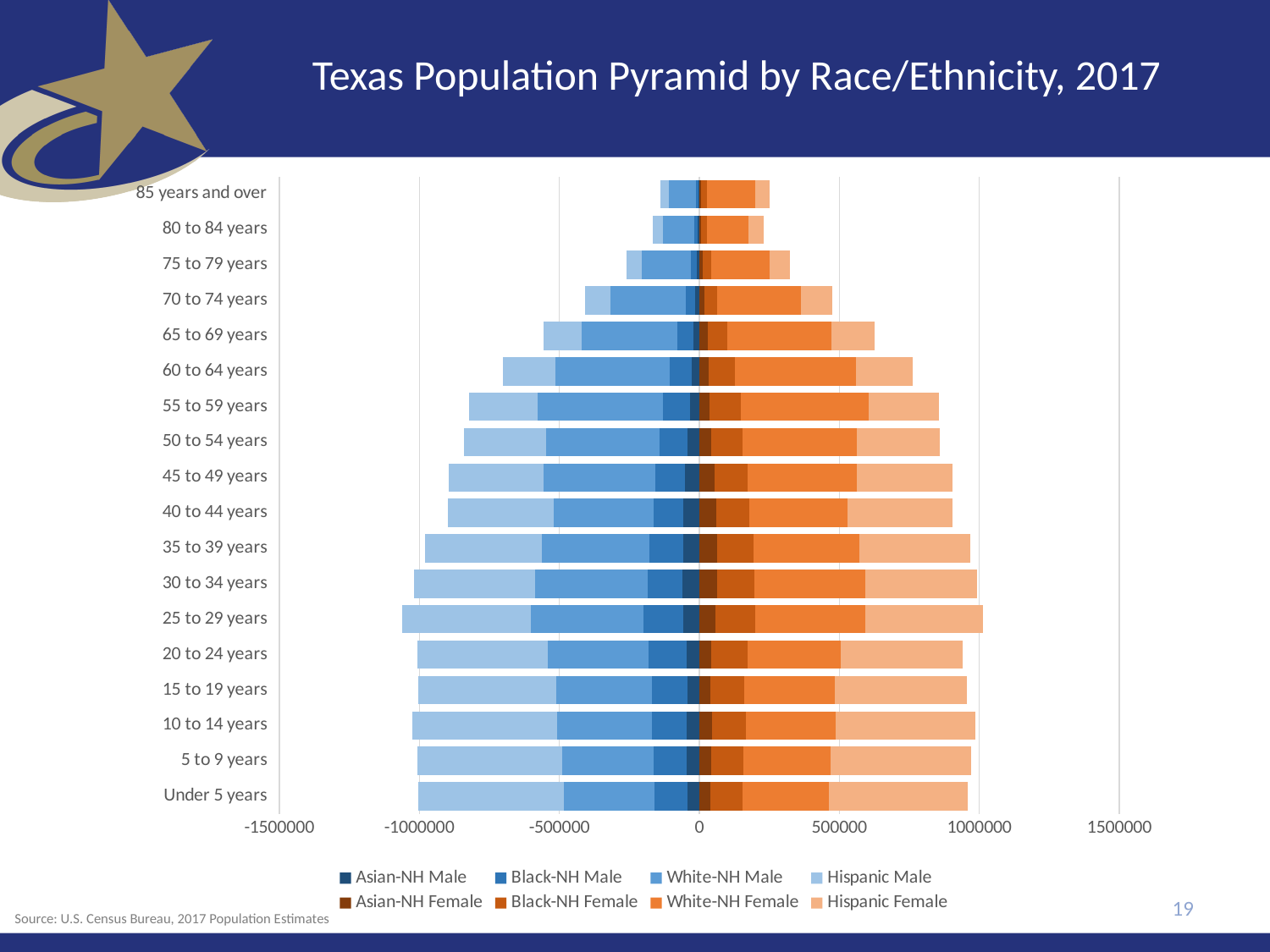
How many series does the legend list? 8 Which is longer, the total female bar for 25 to 29 years or for 75 to 79 years? 25 to 29 years What kind of chart is shown on the slide? Stacked bar chart (population pyramid) Is the total female bar for 85 years and over greater or less than 500000? less Moving from the 25 to 29 years group up to the 85 years and over group, do the bar lengths generally increase or decrease? Decrease Which age group has the longest total bar on the female (right) side? 25 to 29 years How many age groups are plotted on the chart? 18 Is the total female bar for 65 to 69 years greater or less than 500000? greater What is the title of the chart? Texas Population Pyramid by Race/Ethnicity, 2017 Which legend entry is shown in the lightest orange colour? Hispanic Female Does the total male bar for 60 to 64 years extend beyond -500000 on the axis? Yes